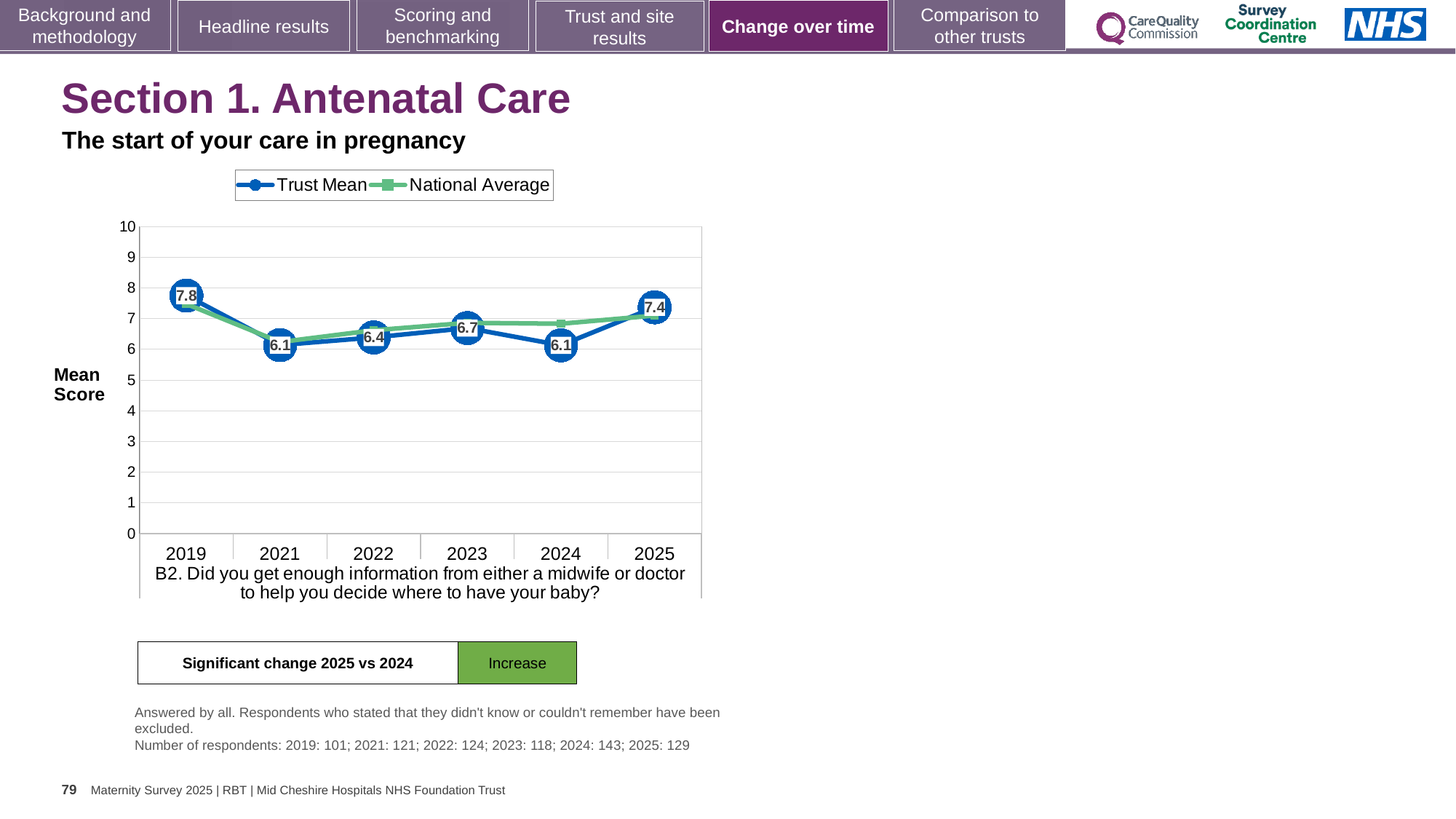
How many series does the legend list? 2 In which year is the Trust Mean highest? 2019 Is the National Average value for 2019 greater or less than 7? greater What is the difference between the Trust Mean in 2019 and in 2021? 1.7 How many years are plotted on the x axis? 6 Which is larger, the Trust Mean in 2025 or in 2024? 2025 What is the Trust Mean value for 2023? 6.7 What kind of chart is shown on the slide? Line chart What is the Trust Mean value for 2025? 7.4 Does the Trust Mean rise or fall from 2024 to 2025? Rise Is the National Average value for 2024 greater or less than 6? greater What is the Trust Mean value for 2019? 7.8